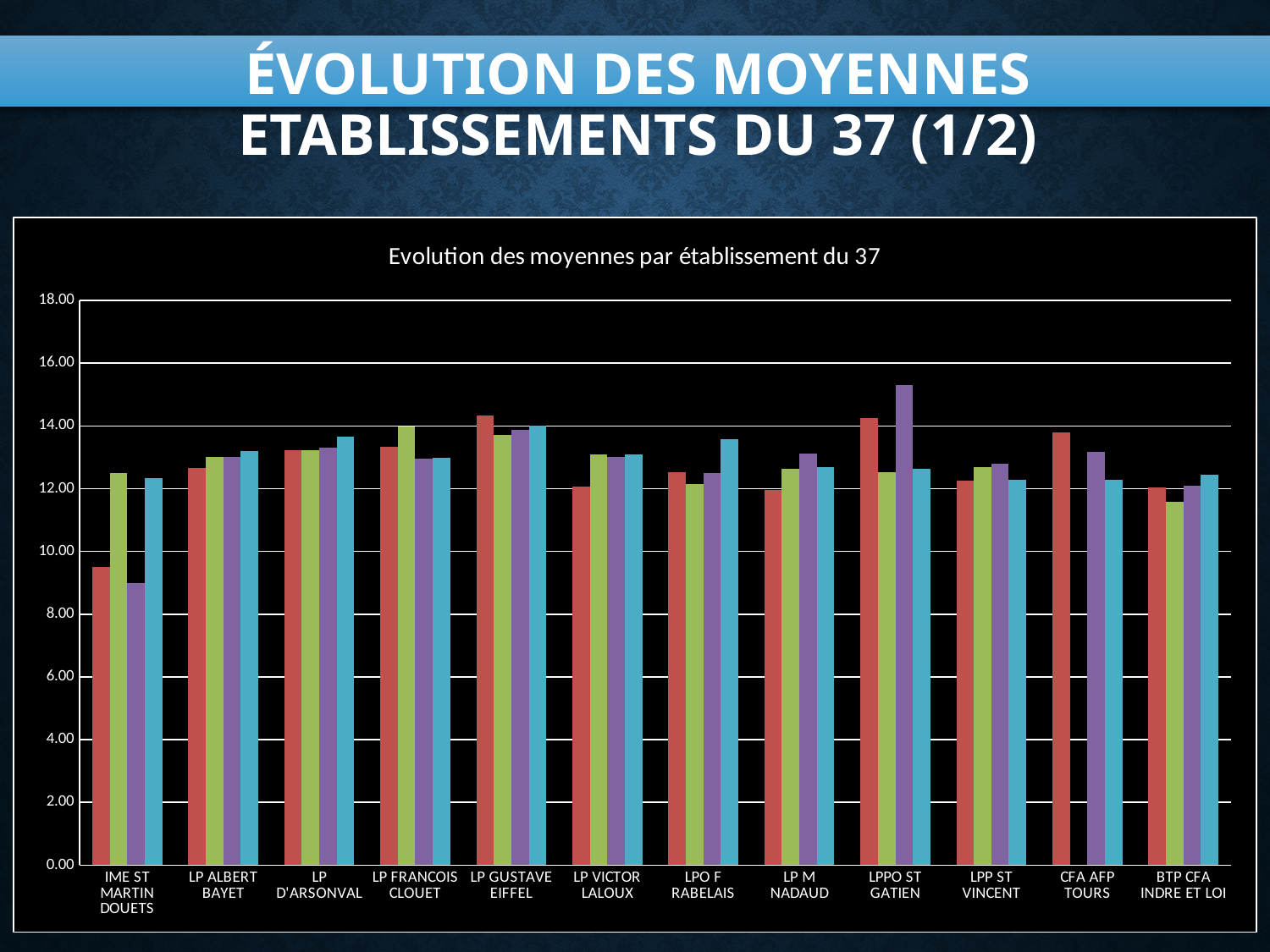
Is the value of the green bar for BTP CFA INDRE ET LOI greater or less than 12.00? less What is the highest value shown on the chart's vertical axis? 18.00 What kind of chart is shown on the slide? bar chart What is the title printed inside the chart area? Evolution des moyennes par établissement du 37 How many bars are plotted for each establishment in the chart? 4 (except CFA AFP TOURS, which has 3) Which is larger: the red bar for LP GUSTAVE EIFFEL or the red bar for IME ST MARTIN DOUETS? LP GUSTAVE EIFFEL How many establishments (categories) are shown on the x axis of the chart? 12 Is the value of the blue bar for LP D'ARSONVAL greater or less than 12.00? greater Is the value of the red bar for IME ST MARTIN DOUETS greater or less than 10.00? less Which establishment has the shortest bar in the whole chart? IME ST MARTIN DOUETS Which establishment has the tallest bar in the whole chart? LPPO ST GATIEN